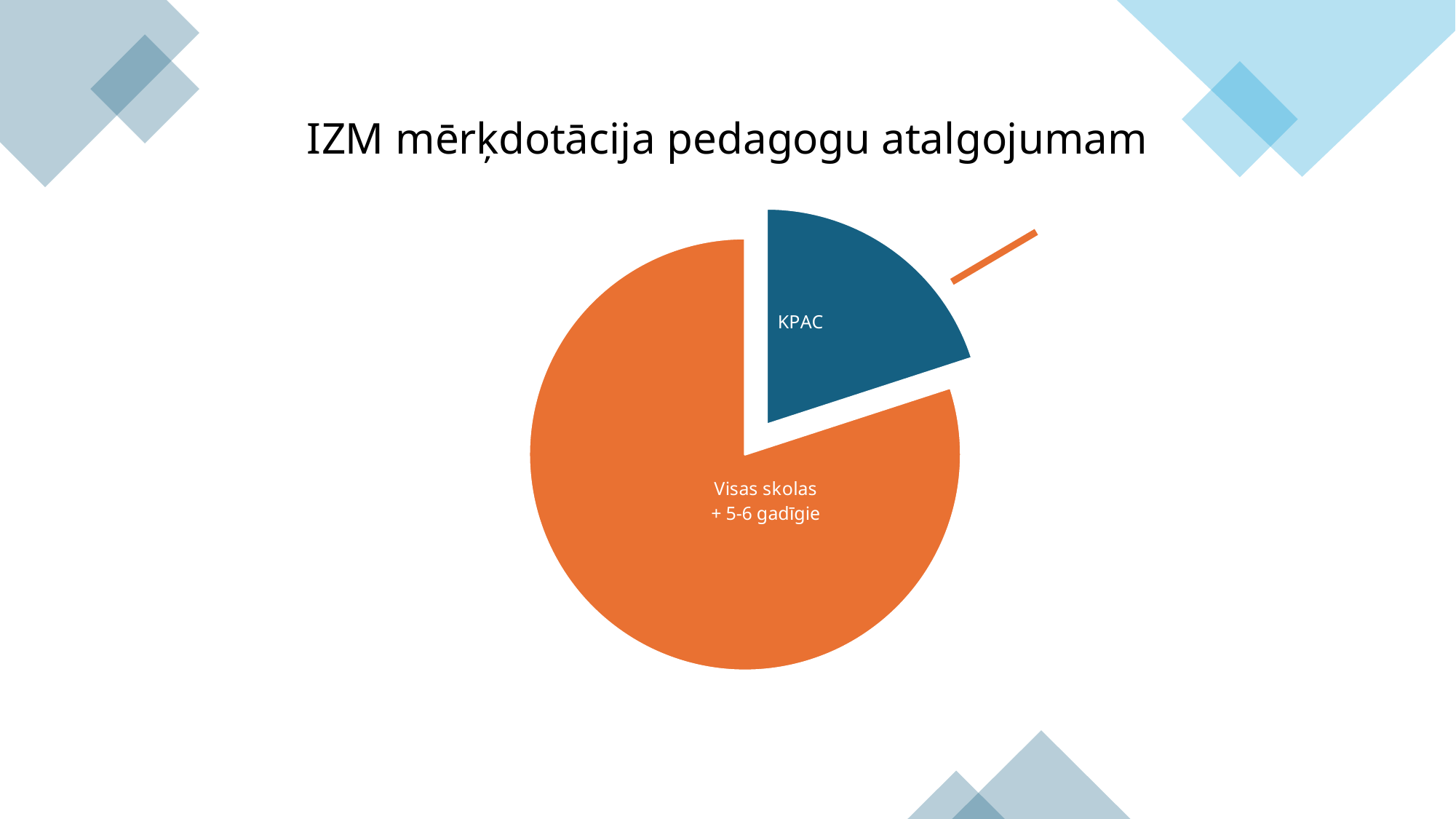
Does the Visas skolas + 5-6 gadīgie slice take up more or less than half of the pie? more What kind of chart is shown on the slide? pie chart Does the KPAC slice take up more or less than half of the pie? less Which labelled slice of the pie chart is the smallest? KPAC Which slice of the pie chart is the largest? Visas skolas + 5-6 gadīgie What is the title of the chart on the slide? IZM mērķdotācija pedagogu atalgojumam What colour is the KPAC slice of the pie chart? blue Which slice is larger, KPAC or Visas skolas + 5-6 gadīgie? Visas skolas + 5-6 gadīgie